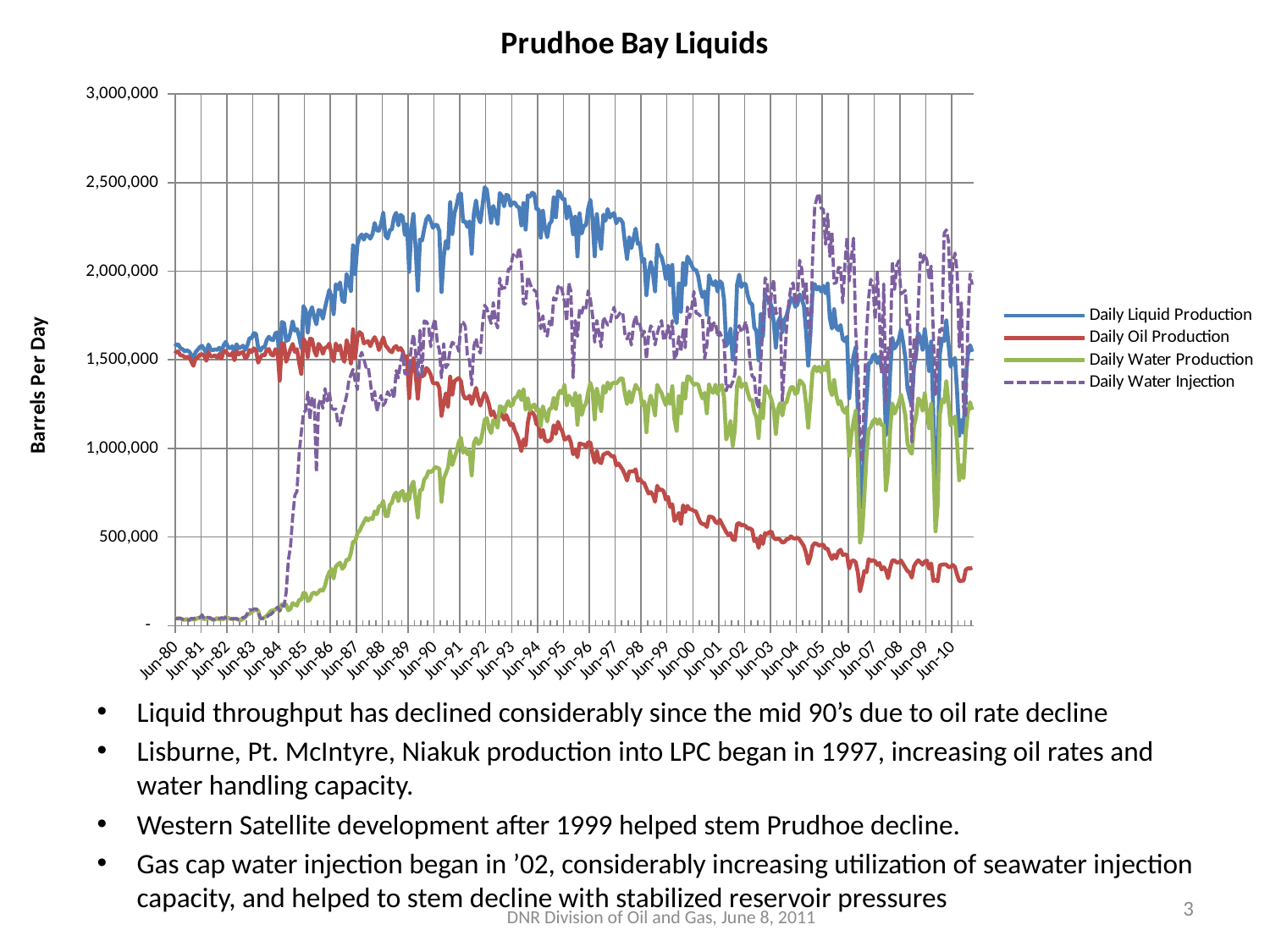
Is the value for Daily Oil Production at Jun-80 greater or less than 1,000,000? greater Is the value for Daily Oil Production at Jun-10 greater or less than 500,000? less Is the value for Daily Liquid Production at Jun-92 greater or less than 2,000,000? greater Which is larger for Daily Liquid Production: the value at Jun-91 or the value at Jun-10? Jun-91 Does Daily Oil Production rise or fall between Jun-87 and Jun-10? fall Does Daily Water Production rise or fall between Jun-84 and Jun-95? rise What is the label on the vertical axis? Barrels Per Day What is the title of the chart? Prudhoe Bay Liquids At Jun-10, which is larger: Daily Water Production or Daily Oil Production? Daily Water Production What kind of chart is shown on the slide? line chart How many series does the legend list? 4